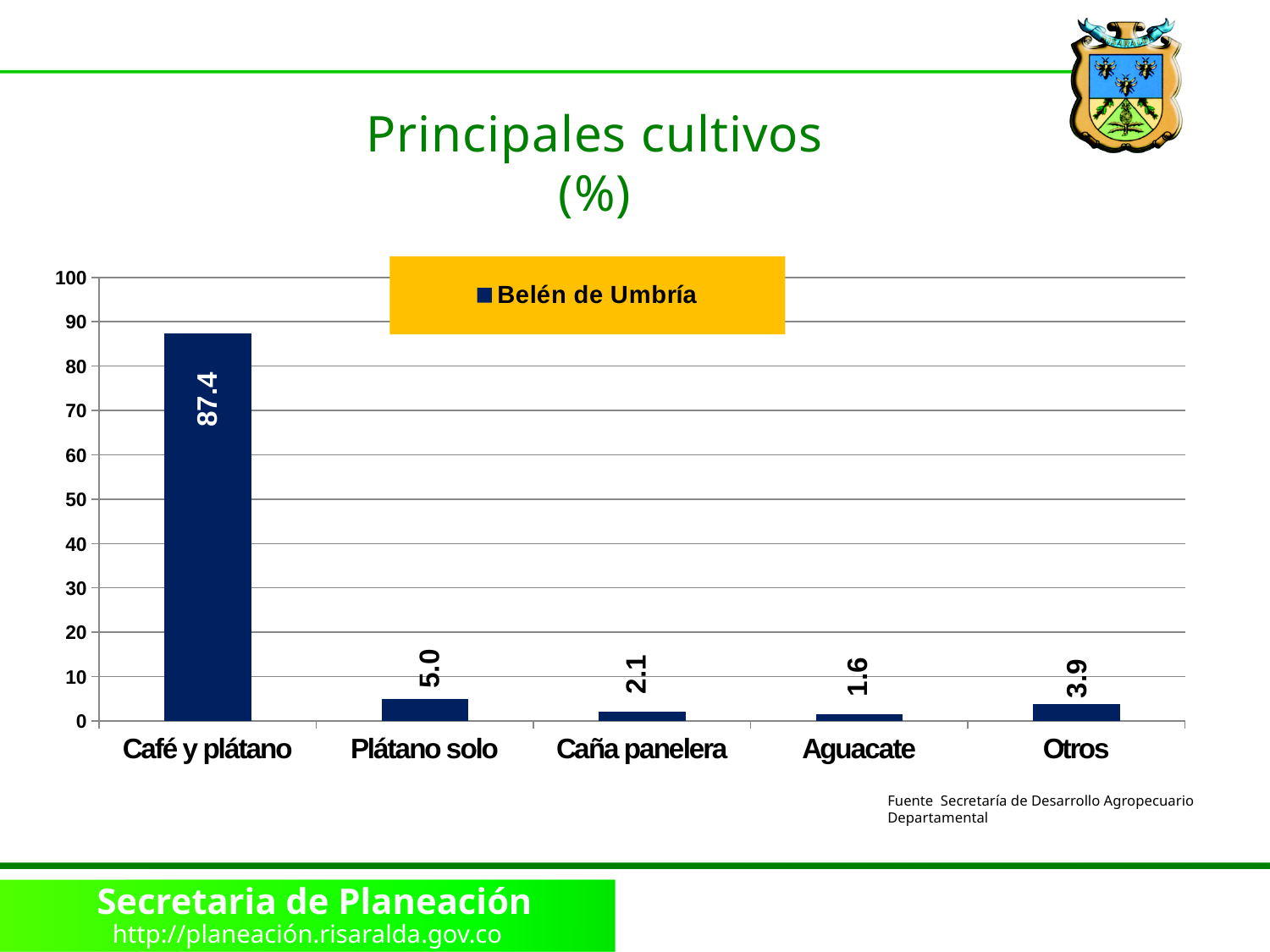
What series name does the legend show? Belén de Umbría What is the value for Aguacate? 1.6 What is the value for Café y plátano? 87.4 What kind of chart is shown on the slide? bar chart What is the value for Plátano solo? 5.0 What is the difference between the values for Café y plátano and Plátano solo? 82.4 What is the value for Otros? 3.9 How many categories are shown on the x axis? 5 Which is larger, the value for Caña panelera or the value for Otros? Otros Which category has the highest value? Café y plátano Which category has the lowest value? Aguacate Is the value for Café y plátano greater or less than 80? greater